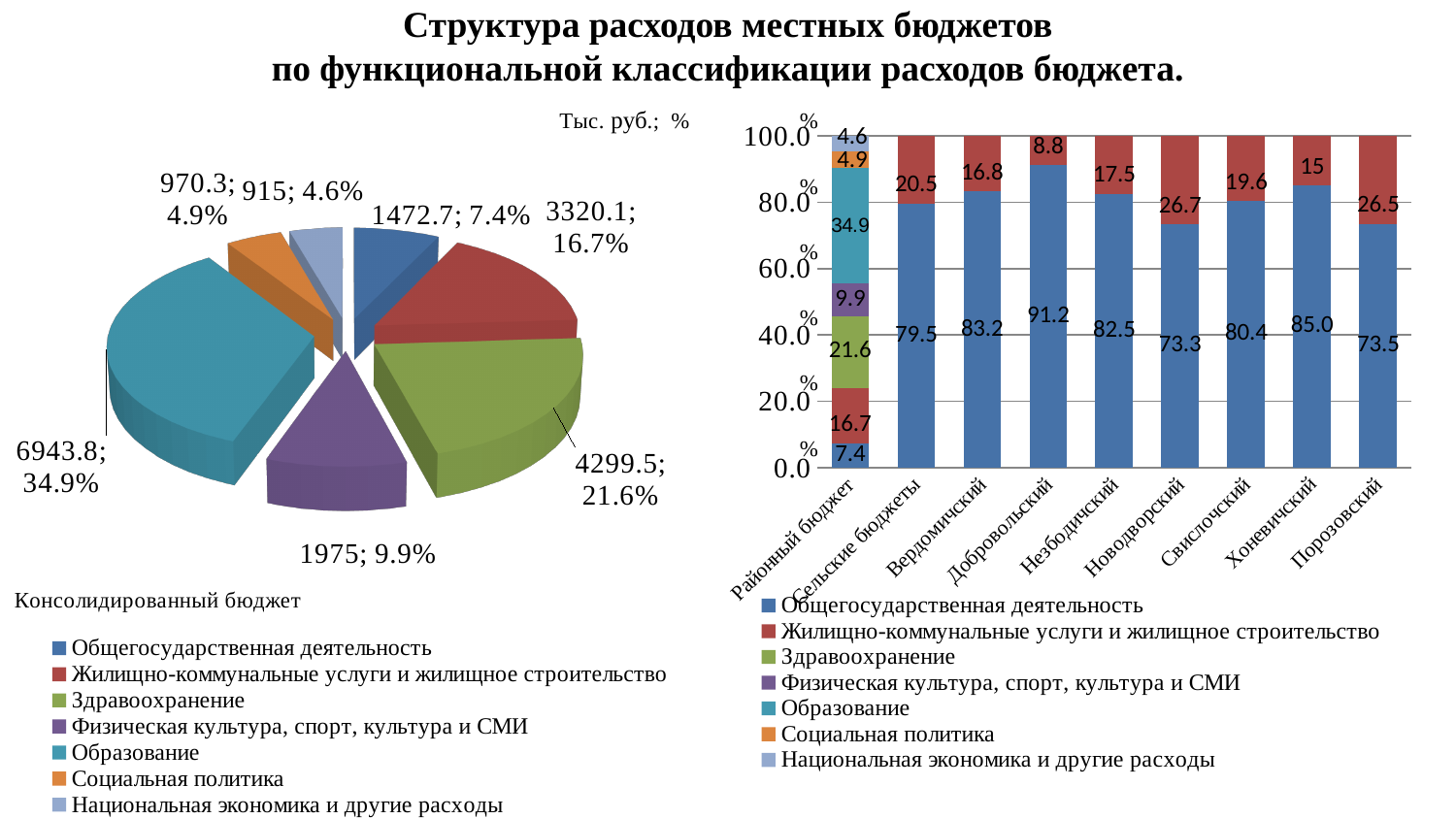
In the bar chart on the right, what is the value of Жилищно-коммунальные услуги и жилищное строительство for Новодворский? 26.7 In the pie chart on the left, what value is shown for Здравоохранение? 4299.5 In the pie chart on the left, what is the share of Образование? 34.9% How many entries does the legend of the pie chart on the left list? 7 What kind of chart is the chart on the right? Stacked bar chart In the bar chart on the right, which is larger: the Общегосударственная деятельность value for Свислочский or for Порозовский? Свислочский In the bar chart on the right, which category has the highest value for Общегосударственная деятельность? Добровольский In the pie chart on the left, which category has the smallest slice? Национальная экономика и другие расходы In the bar chart on the right, how many categories are shown on the x axis? 9 In the pie chart on the left, which category has the largest slice? Образование In the bar chart on the right, what is the value of Общегосударственная деятельность for Добровольский? 91.2 In the pie chart on the left, what is the difference between the values for Здравоохранение and Жилищно-коммунальные услуги и жилищное строительство? 979.4